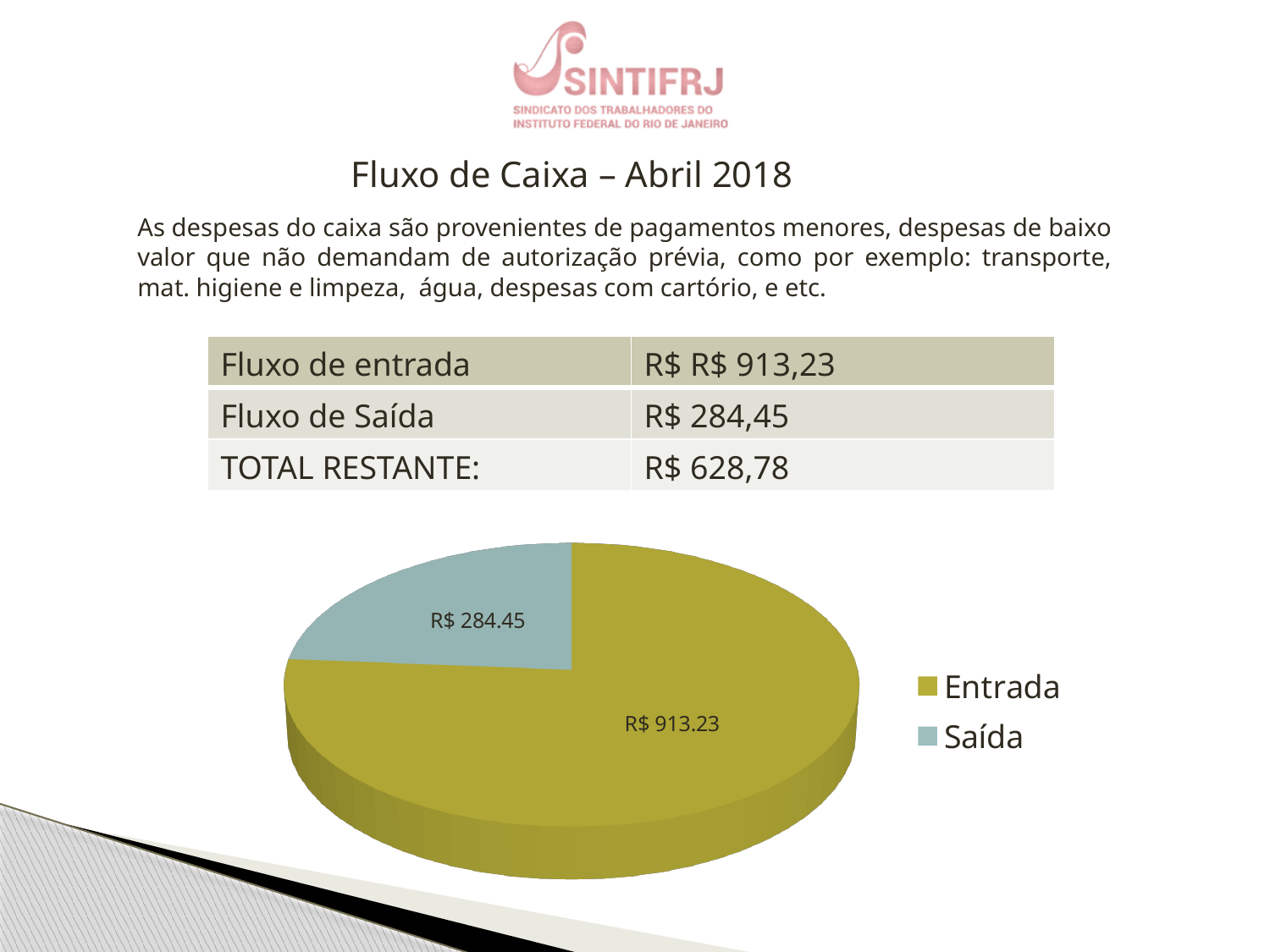
How many entries does the pie chart's legend list? 2 Which is larger in the pie chart, Entrada or Saída? Entrada What colour is the Saída slice in the pie chart? Light blue-grey Which slice of the pie chart is the largest? Entrada What are the two entries listed in the pie chart's legend? Entrada and Saída What is the difference between the Entrada and Saída values in the pie chart? R$ 628.78 What is the value of the Saída slice in the pie chart? R$ 284.45 What kind of chart is shown on the slide? Pie chart What is the combined total of the two slices in the pie chart? R$ 1197.68 How many slices does the pie chart have? 2 Which slice of the pie chart is the smallest? Saída What is the value of the Entrada slice in the pie chart? R$ 913.23